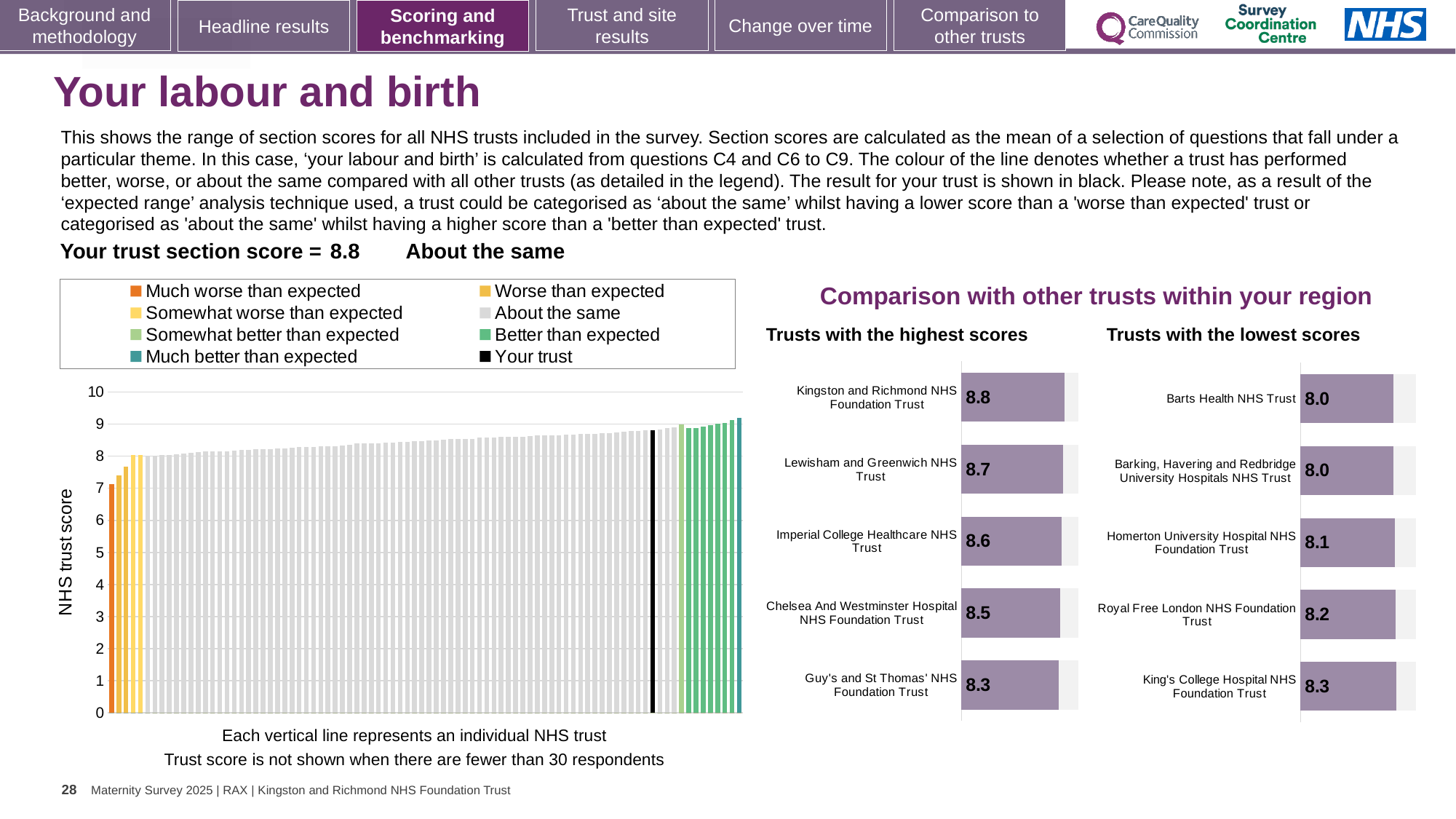
In the main chart on the left, is the value of the tallest (rightmost) bar greater or less than 9? greater In the 'Trusts with the lowest scores' chart, which trust has the highest score? King's College Hospital NHS Foundation Trust In the 'Trusts with the highest scores' chart, which trust has the highest score? Kingston and Richmond NHS Foundation Trust How many trusts are shown in the 'Trusts with the highest scores' chart? 5 What kind of chart is the main chart on the left showing NHS trust scores? bar chart In the main 'NHS trust score' chart, do the bar values rise or fall from left to right? rise In the 'Trusts with the highest scores' chart, what is the difference between the scores of Kingston and Richmond NHS Foundation Trust and Guy's and St Thomas' NHS Foundation Trust? 0.5 In the 'Trusts with the lowest scores' chart, how much higher is King's College Hospital NHS Foundation Trust's score than Barts Health NHS Trust's score? 0.3 In the 'Trusts with the highest scores' chart, what is the score for Lewisham and Greenwich NHS Trust? 8.7 In the 'Trusts with the lowest scores' chart, what is the score for Homerton University Hospital NHS Foundation Trust? 8.1 Which has the higher score: Imperial College Healthcare NHS Trust in the highest-scores chart or Royal Free London NHS Foundation Trust in the lowest-scores chart? Imperial College Healthcare NHS Trust How many entries does the legend of the main 'NHS trust score' chart list? 8